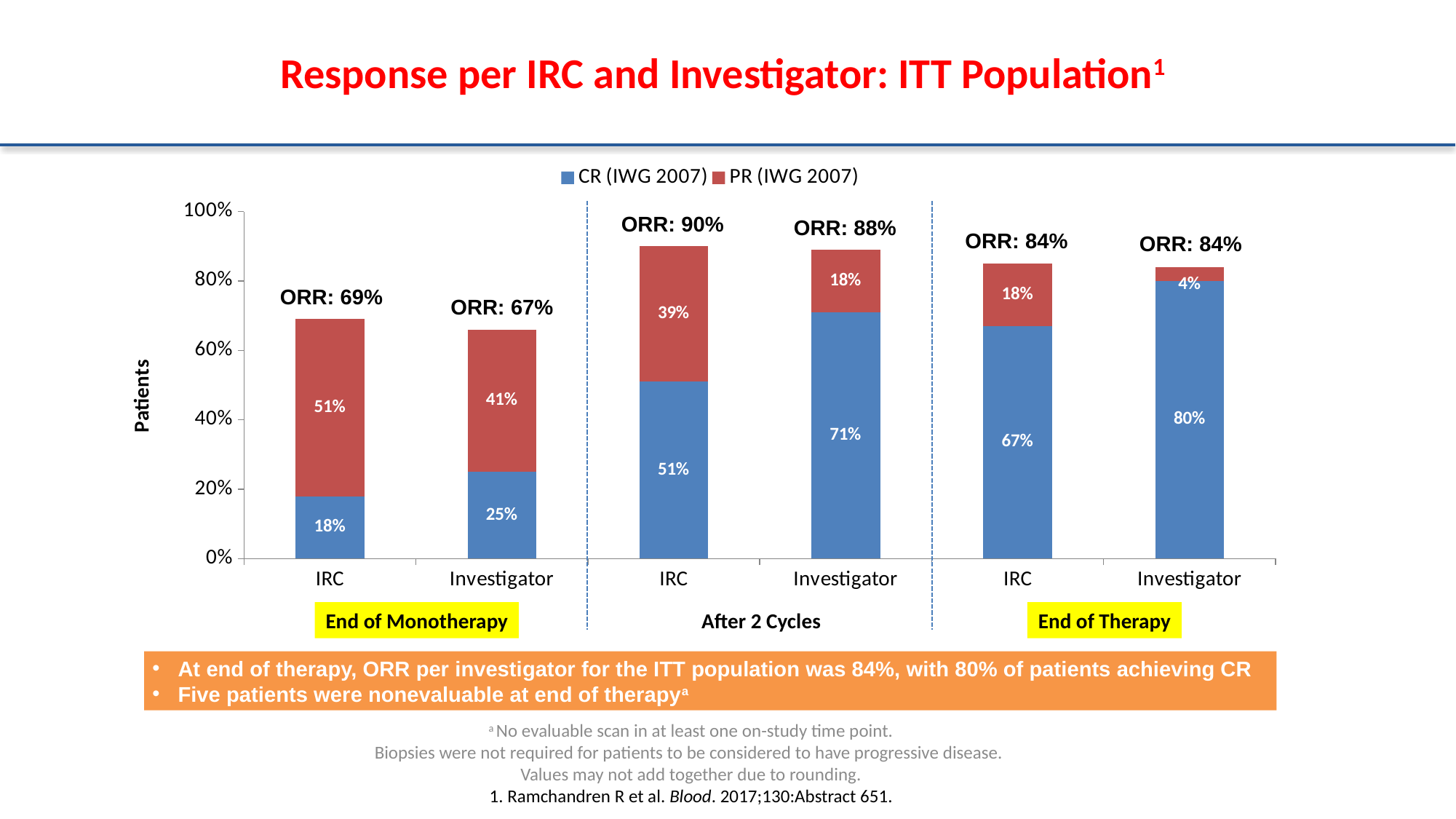
Which bar has the lowest PR (IWG 2007) value? Investigator at End of Therapy (4%) How many bars are plotted in the chart? 6 What is the PR (IWG 2007) value for the IRC bar at End of Monotherapy? 51% Is the total height of the IRC bar at End of Monotherapy greater or less than 60%? greater What kind of chart is shown on the slide? Stacked bar chart How many series does the legend list? 2 Does the CR (IWG 2007) value for IRC rise or fall from End of Monotherapy to After 2 Cycles to End of Therapy? Rise What ORR is shown above the IRC bar in the After 2 Cycles section? ORR: 90% After 2 Cycles, which has the larger CR (IWG 2007) value, IRC or Investigator? Investigator At End of Therapy, what is the difference between the CR value for Investigator and the CR value for IRC? 13 percentage points Which bar has the highest CR (IWG 2007) value? Investigator at End of Therapy (80%) What is the CR (IWG 2007) value for the Investigator bar at End of Therapy? 80%